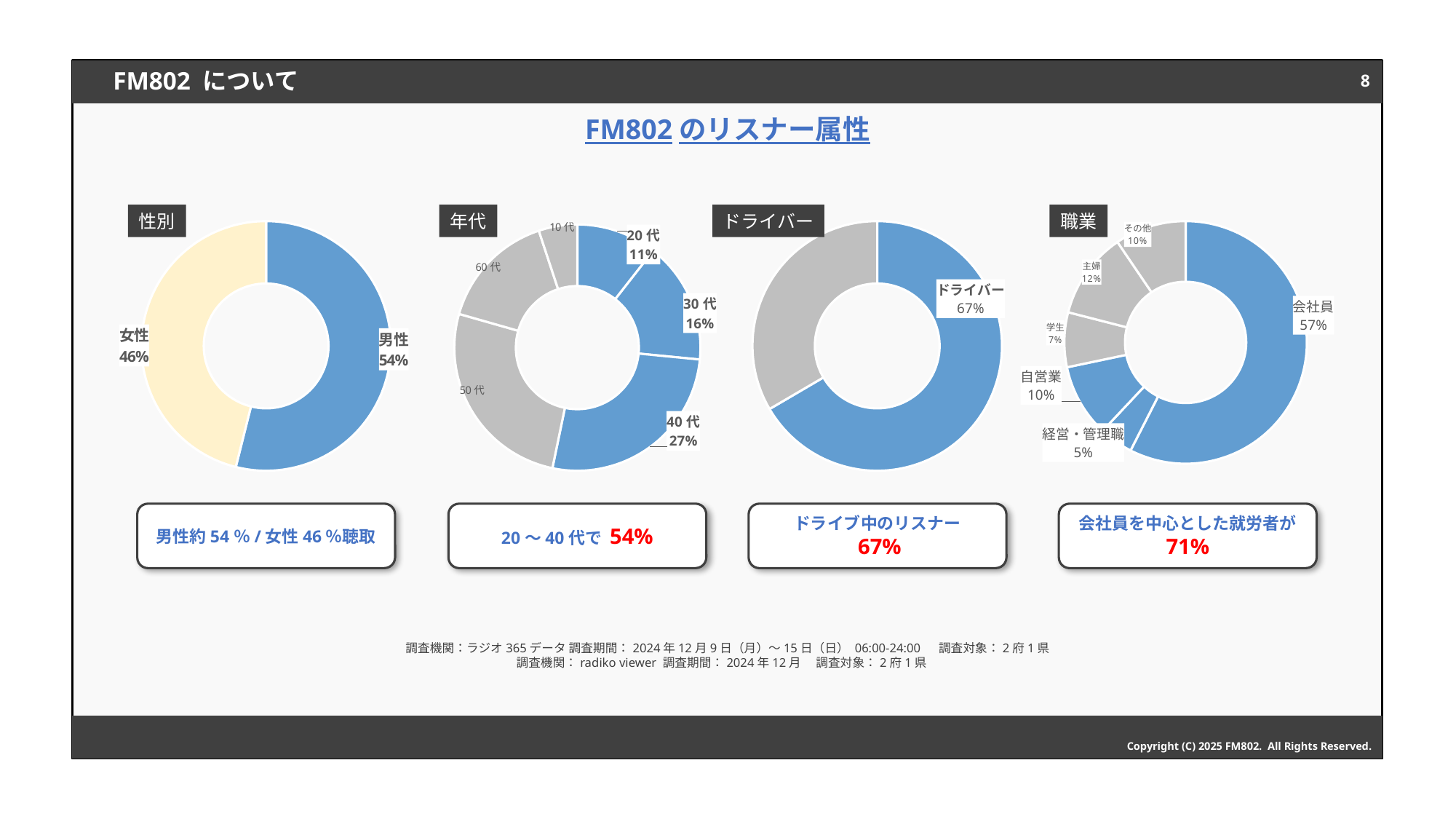
In the 職業 chart, which occupation has the largest share? 会社員 In the 性別 chart, what percentage is shown for 男性? 54% What kind of chart is used for the 性別 data? Donut (pie) chart In the 職業 chart, which occupation has the smallest share? 経営・管理職 In the 職業 chart, what percentage is shown for 主婦? 12% In the 年代 chart, what is the difference between the 40代 and 30代 percentages? 11% In the 性別 chart, what percentage is shown for 女性? 46% In the 年代 chart, how many age categories are shown? 6 In the ドライバー chart, what percentage is shown for ドライバー? 67% In the 性別 chart, which is larger, 男性 or 女性? 男性 In the 年代 chart, what percentage is shown for 20代? 11% In the 年代 chart, what percentage is shown for 40代? 27%